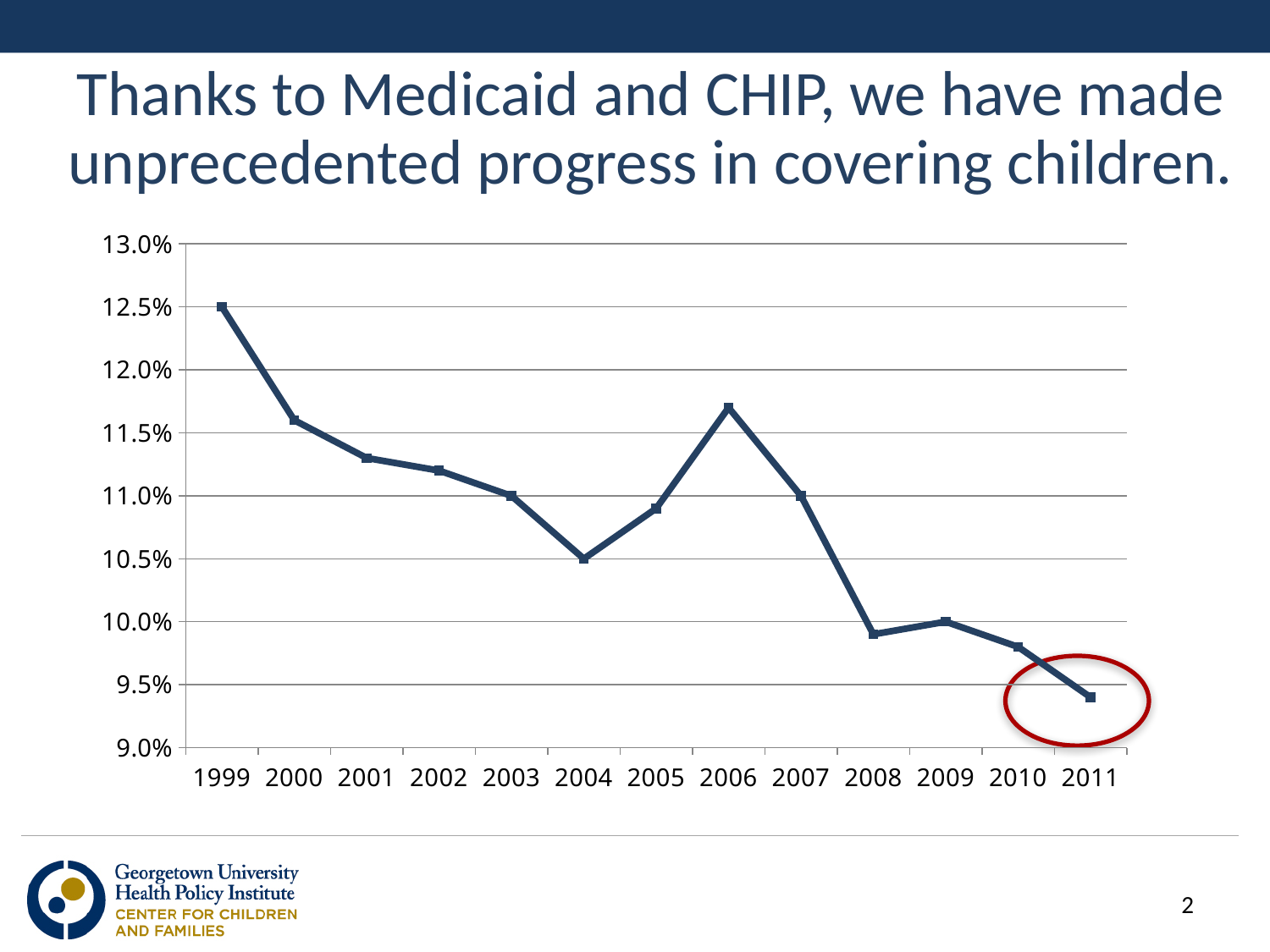
Is the value for 2006 greater or less than 11.5%? greater What is the value for 2004? 10.5% What is the value for 1999? 12.5% Which is larger, the value for 2006 or the value for 2007? 2006 Overall, do the values rise or fall from 1999 to 2011? fall Is the value for 2011 greater or less than 9.5%? less Which year has the lowest value? 2011 Which year has the highest value? 1999 What is the value for 2009? 10.0% What kind of chart is shown on the slide? line chart What is the difference between the values for 1999 and 2004? 2.0 percentage points How many years are plotted on the x axis? 13